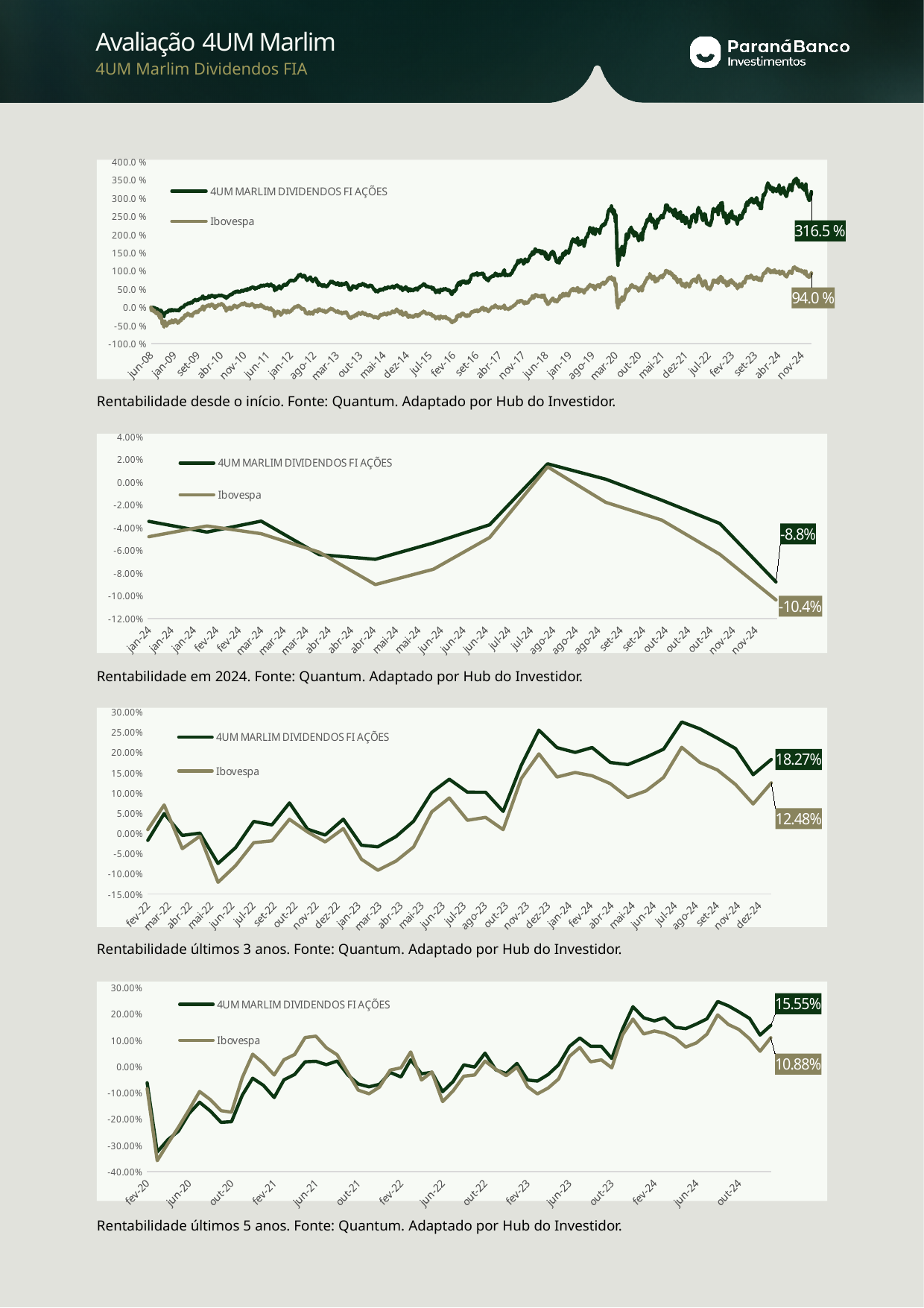
In the 'Rentabilidade desde o início' chart (top chart), what is the final labelled value for 4UM MARLIM DIVIDENDOS FI AÇÕES? 316.5 % What kind of chart is the 'Rentabilidade desde o início' chart (top chart)? Line chart In the 'Rentabilidade em 2024' chart (second chart), what is the final labelled value for 4UM MARLIM DIVIDENDOS FI AÇÕES? -8.8% In the 'Rentabilidade em 2024' chart (second chart), what is the final labelled value for Ibovespa? -10.4% How many series does the legend list in the 'Rentabilidade últimos 5 anos' chart (bottom chart)? 2 In the 'Rentabilidade desde o início' chart (top chart), what is the difference between the final labelled values of 4UM MARLIM DIVIDENDOS FI AÇÕES and Ibovespa? 222.5 % In the 'Rentabilidade últimos 3 anos' chart (third chart), what is the final labelled value for 4UM MARLIM DIVIDENDOS FI AÇÕES? 18.27% In the 'Rentabilidade últimos 5 anos' chart (bottom chart), what is the final labelled value for 4UM MARLIM DIVIDENDOS FI AÇÕES? 15.55% In the 'Rentabilidade últimos 3 anos' chart (third chart), what is the difference between the final labelled values of 4UM MARLIM DIVIDENDOS FI AÇÕES and Ibovespa? 5.79% In the 'Rentabilidade em 2024' chart (second chart), which series ends with the higher labelled value, 4UM MARLIM DIVIDENDOS FI AÇÕES or Ibovespa? 4UM MARLIM DIVIDENDOS FI AÇÕES In the 'Rentabilidade desde o início' chart (top chart), what is the final labelled value for Ibovespa? 94.0 % In the 'Rentabilidade últimos 5 anos' chart (bottom chart), what is the final labelled value for Ibovespa? 10.88%